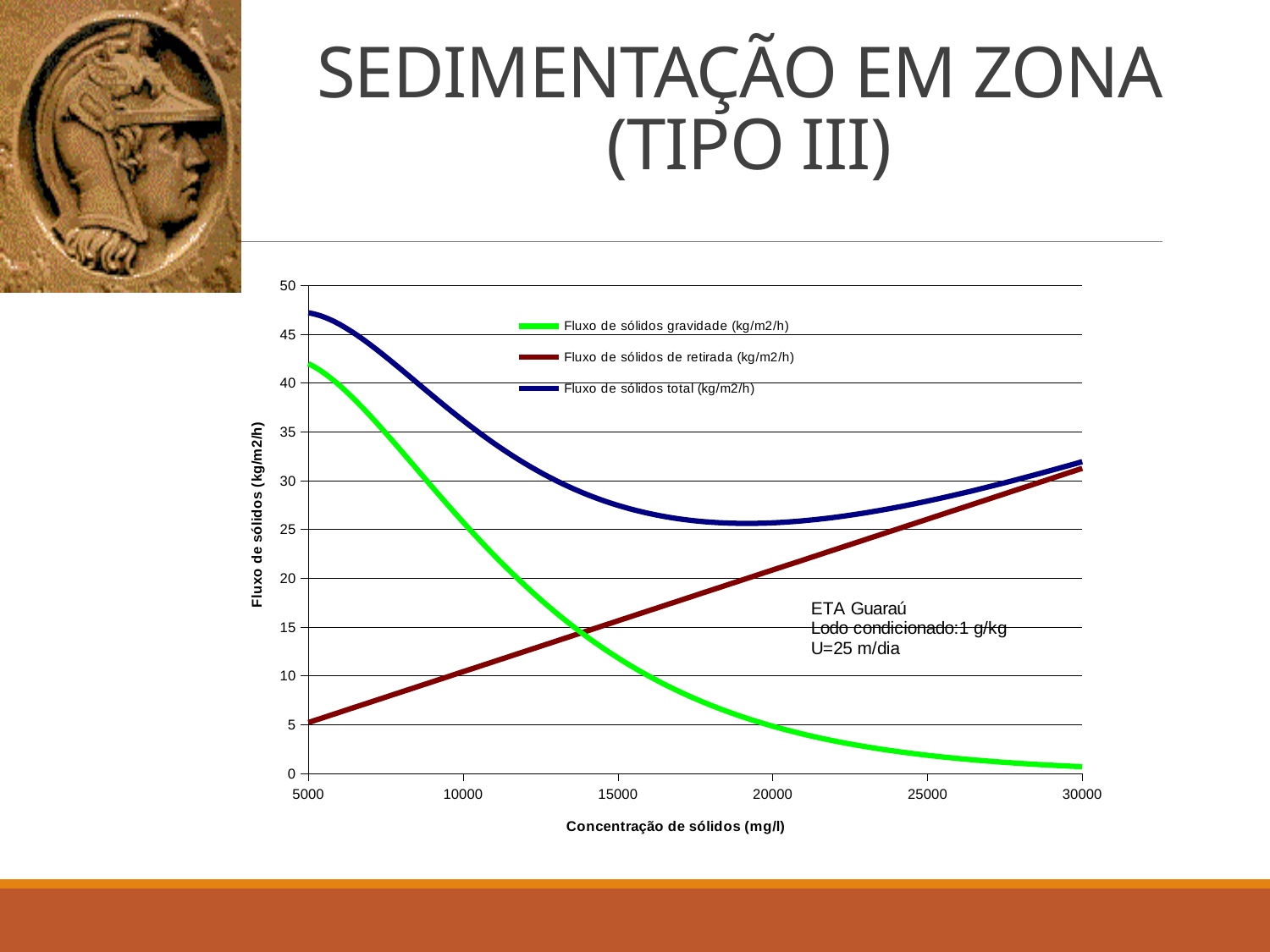
Is the value of Fluxo de sólidos gravidade at 5000 mg/l greater or less than 40? greater What kind of chart is shown on the slide? line chart At 30000 mg/l, which is larger: Fluxo de sólidos de retirada or Fluxo de sólidos gravidade? Fluxo de sólidos de retirada Is the value of Fluxo de sólidos total at 5000 mg/l greater or less than 45? greater Which series is drawn in green? Fluxo de sólidos gravidade (kg/m2/h) Is the value of Fluxo de sólidos gravidade at 30000 mg/l greater or less than 5? less At 10000 mg/l, which is larger: Fluxo de sólidos gravidade or Fluxo de sólidos de retirada? Fluxo de sólidos gravidade Does the Fluxo de sólidos de retirada series rise or fall as concentration increases along the x axis? rise How many series does the legend list? 3 Does the Fluxo de sólidos gravidade series rise or fall as concentration increases along the x axis? fall What is the title of the x axis? Concentração de sólidos (mg/l)